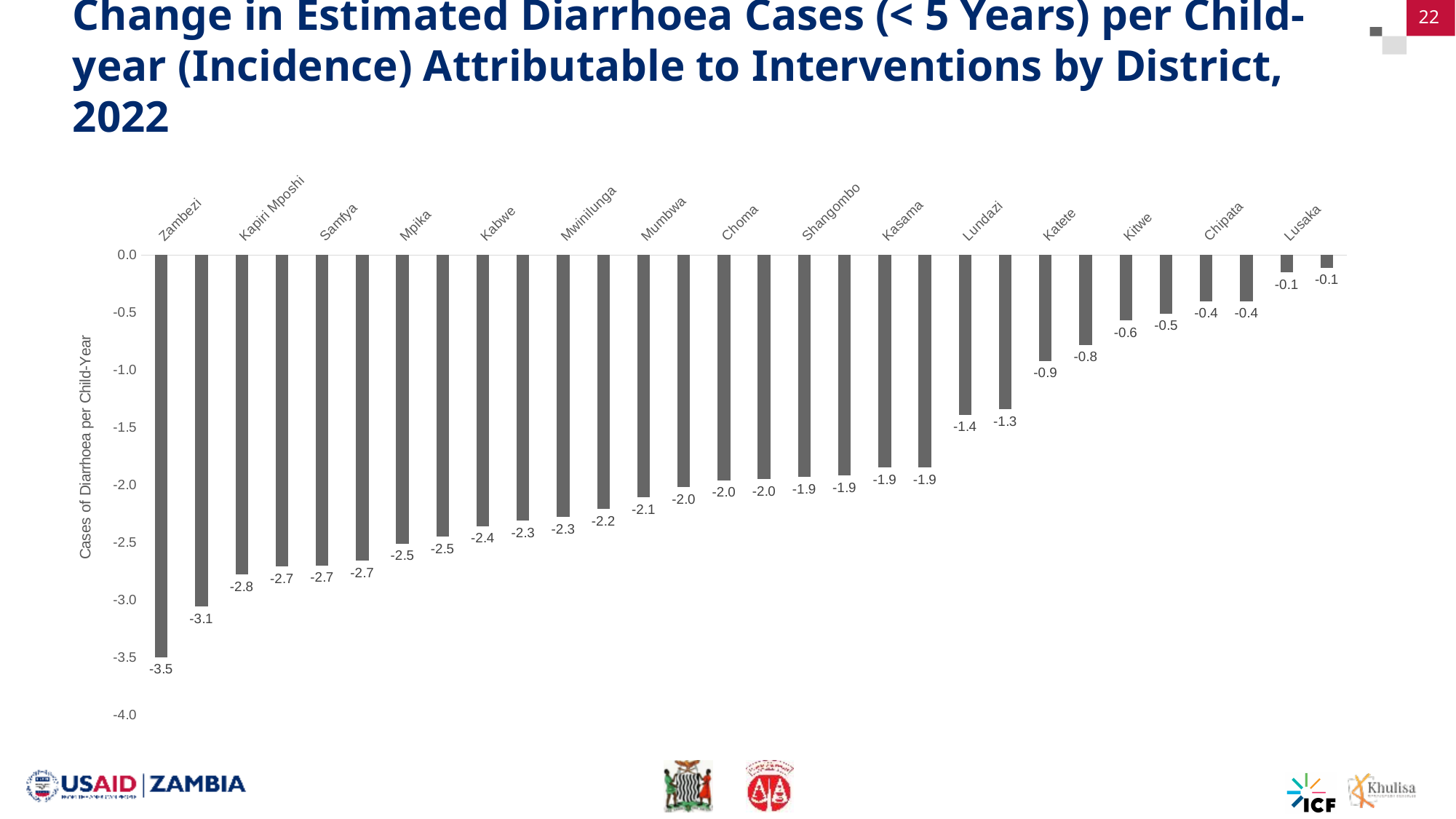
Do the values rise or fall moving from left to right along the x axis? rise How many bars are plotted in the chart? 30 Which district has the lowest (most negative) change in diarrhoea cases per child-year? Zambezi What is the change in diarrhoea cases per child-year for Kapiri Mposhi? -2.8 Which has the larger (less negative) value, Zambezi or Kitwe? Kitwe What is the change in diarrhoea cases per child-year for Lundazi? -1.4 What is the change in diarrhoea cases per child-year for Lusaka? -0.1 What is the change in diarrhoea cases per child-year for Katete? -0.9 What is the change in diarrhoea cases per child-year for Zambezi? -3.5 What is the difference between the values for Zambezi and Lusaka? 3.4 What is the title of the vertical axis? Cases of Diarrhoea per Child-Year What kind of chart is shown on the slide? bar chart